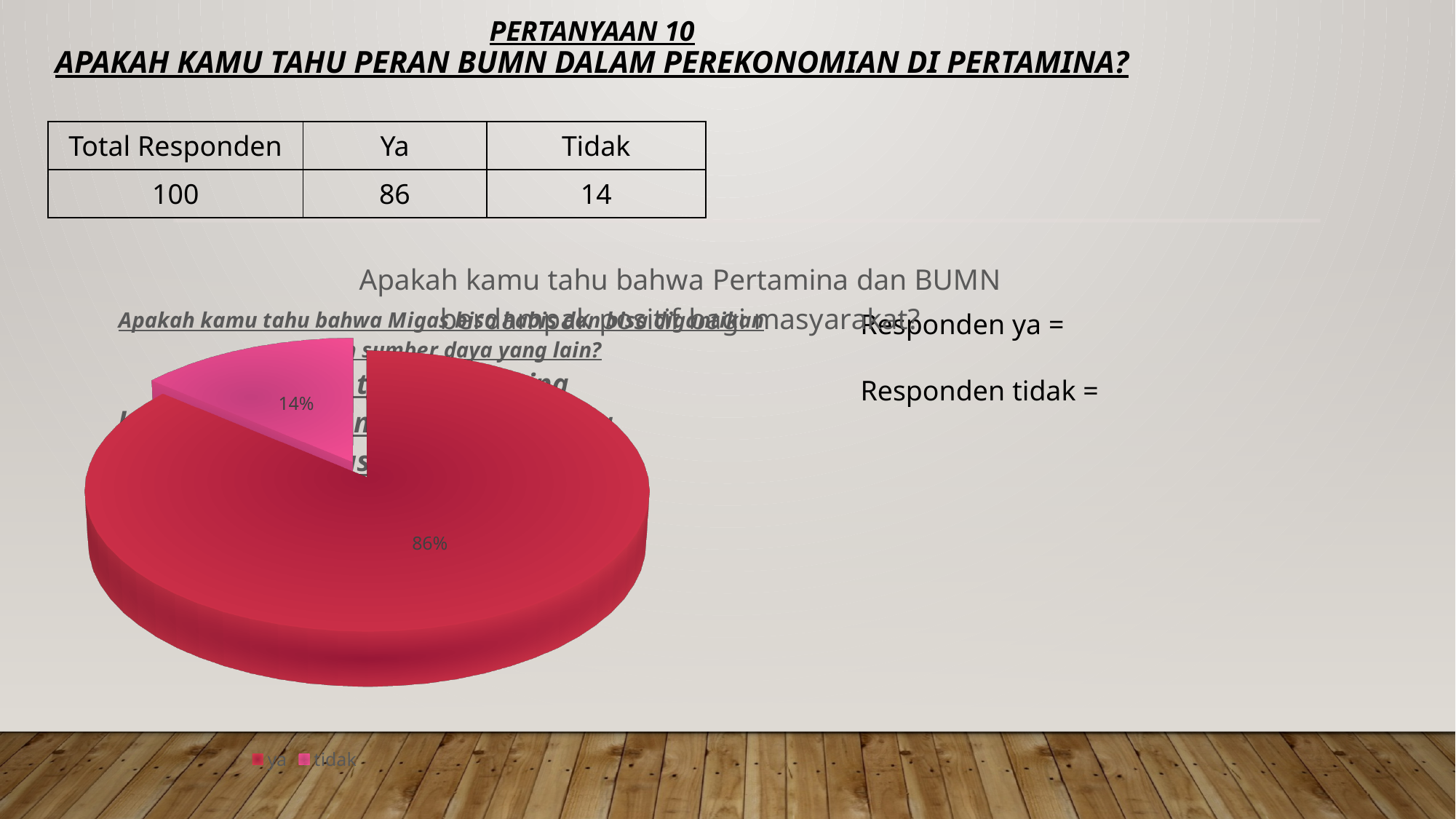
What kind of chart is shown on the slide? pie chart Which is larger in the pie chart, "ya" or "tidak"? ya How many slices does the pie chart have? 2 What share of the pie does the "tidak" slice represent? 14% What are the two legend entries of the pie chart? ya, tidak How many entries does the pie chart's legend list? 2 Which legend entry is shown in the lighter pink colour in the pie chart? tidak Which slice of the pie chart is the largest? ya What percentage of the pie chart is the "ya" slice? 86% What percentage of the pie chart is the "tidak" slice? 14% Which slice of the pie chart is the smallest? tidak What is the difference in percentage points between the "ya" and "tidak" slices? 72